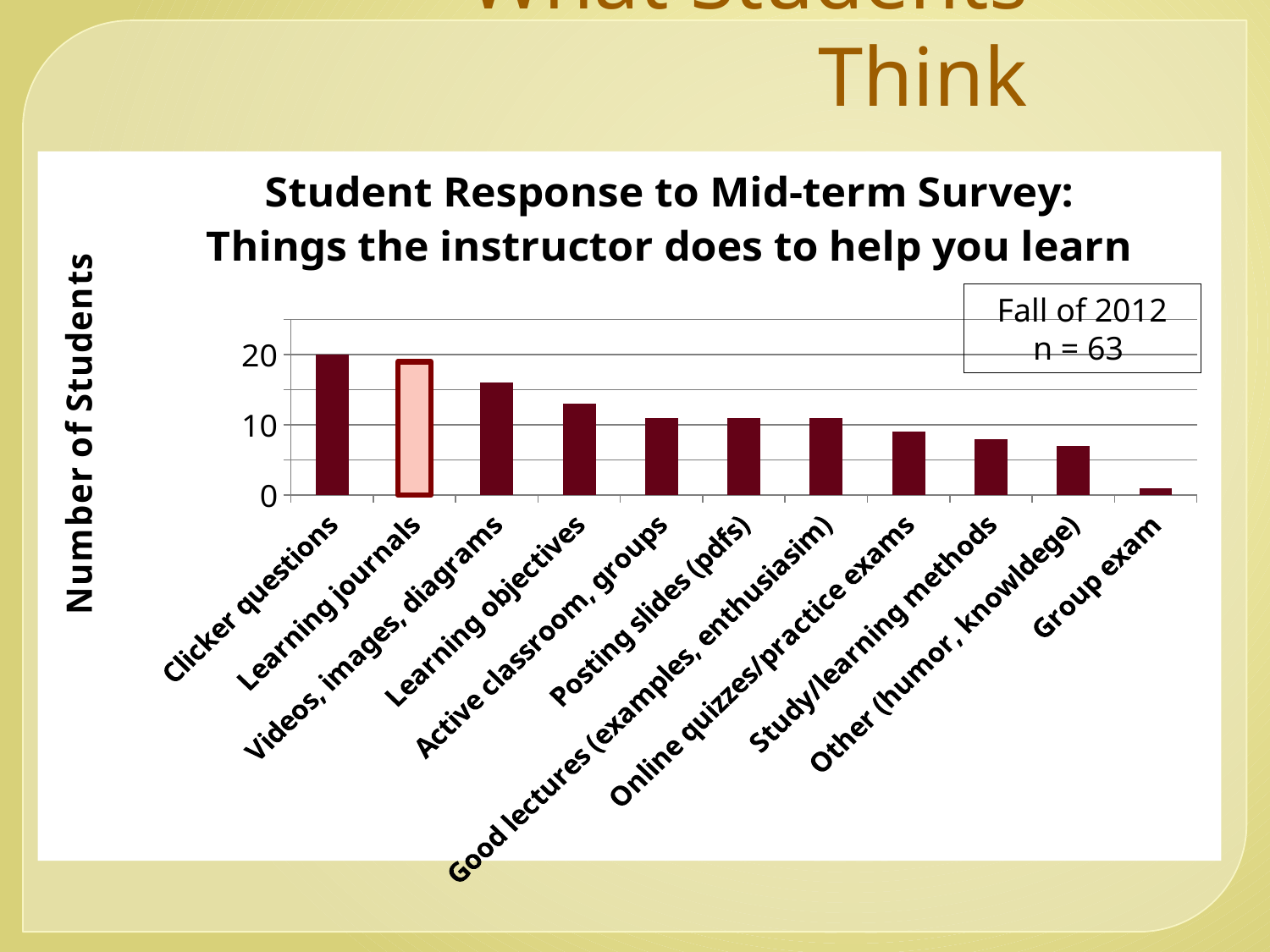
Which category has the lowest number of students? Group exam What is the label of the y axis? Number of Students Is the value for Videos, images, diagrams greater or less than 10? greater What kind of chart is shown on the slide? bar chart How many categories are shown on the x axis? 11 Which category has the highest number of students? Clicker questions Is the value for Other (humor, knowldege) greater or less than 10? less Do the bar values rise or fall from left to right along the x axis? fall Is the value for Group exam greater or less than 10? less Which has a larger value, Videos, images, diagrams or Learning objectives? Videos, images, diagrams According to the text box on the chart, what is the value of n? 63